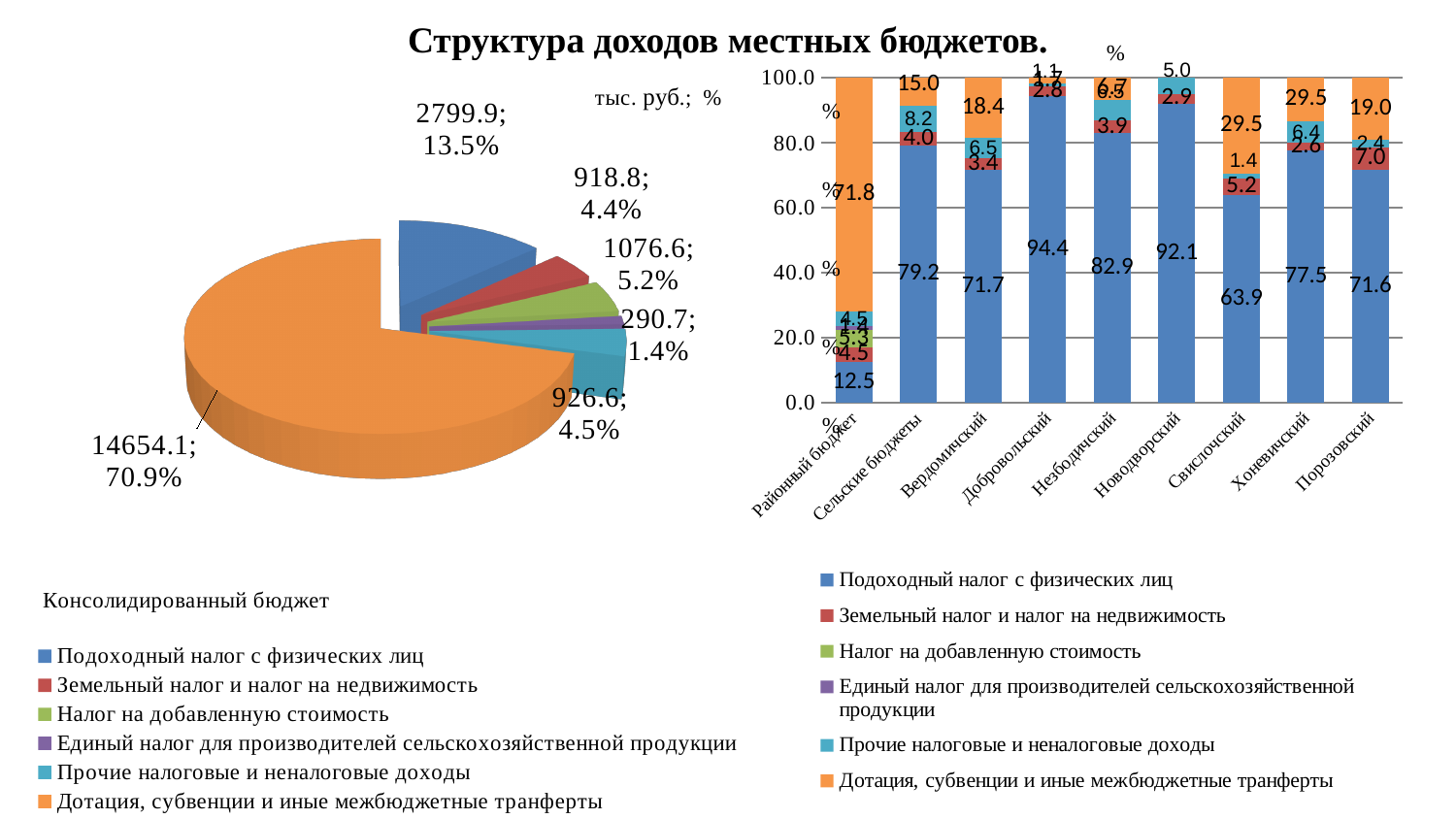
On the stacked bar chart (right), what is the value of Дотация, субвенции и иные межбюджетные трансферты for Районный бюджет? 71.8 On the pie chart (left), which category has the smallest slice? Единый налог для производителей сельскохозяйственной продукции On the stacked bar chart (right), what is the value of Подоходный налог с физических лиц for Добровольский? 94.4 On the pie chart (left), what is the value in тыс. руб. for Дотация, субвенции и иные межбюджетные трансферты? 14654.1 On the stacked bar chart (right), which budget has the lowest value for Подоходный налог с физических лиц? Районный бюджет On the stacked bar chart (right), what is the difference in Подоходный налог с физических лиц between Добровольский and Вердомичский? 22.7 What kind of chart is the left chart? Pie chart On the stacked bar chart (right), which has the larger value for Подоходный налог с физических лиц: Сельские бюджеты or Незбодичский? Незбодичский How many budget categories are shown on the x axis of the stacked bar chart (right)? 9 On the pie chart (left), what is the value in тыс. руб. for Подоходный налог с физических лиц? 2799.9 How many series does the legend of the stacked bar chart (right) list? 6 On the pie chart (left), what share of the consolidated budget comes from Дотация, субвенции и иные межбюджетные трансферты? 70.9%